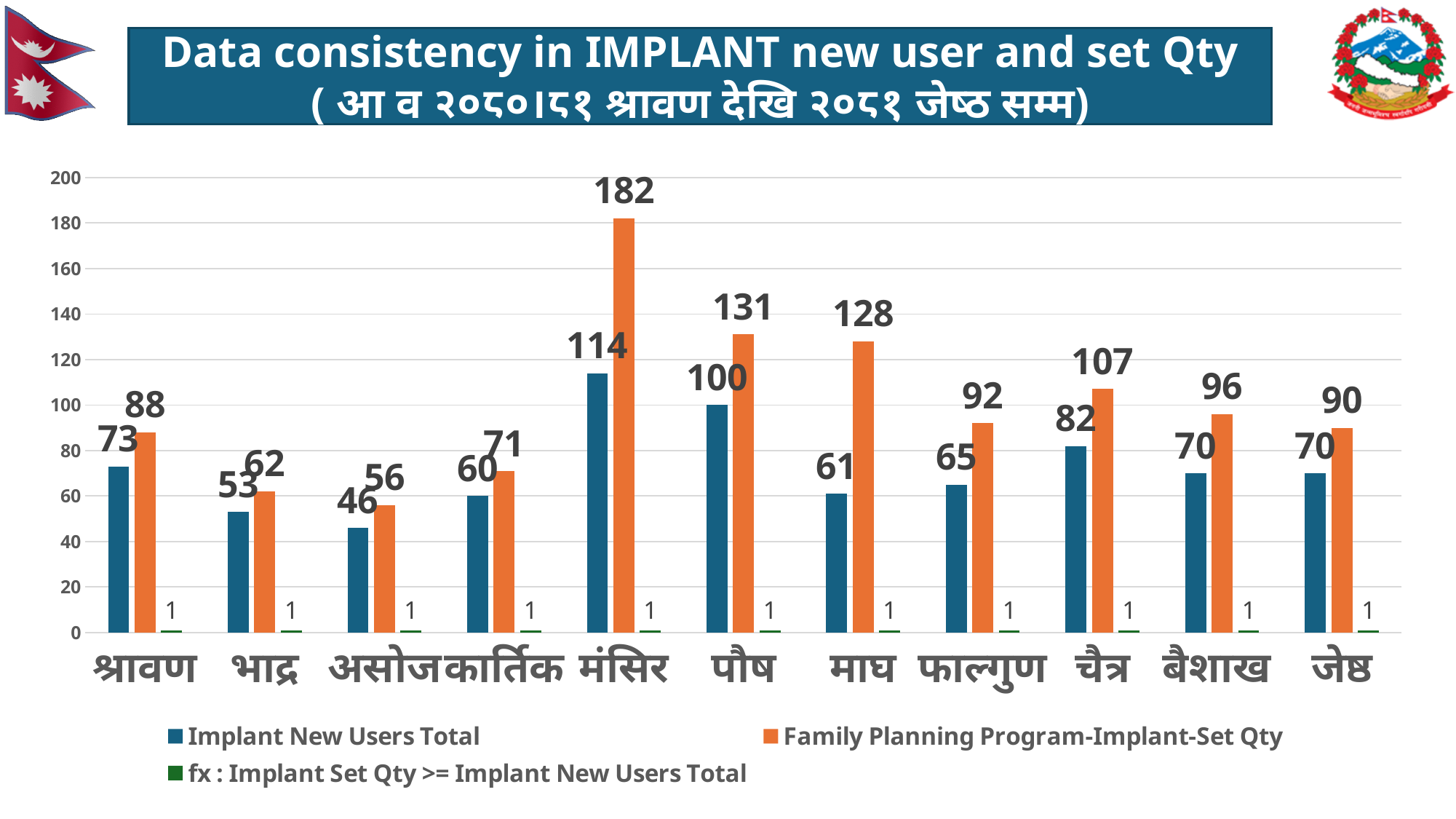
What is the Family Planning Program-Implant-Set Qty value for मंसिर? 182 What is the Implant New Users Total value for पौष? 100 How many series does the legend list? 3 What is the difference between the Implant Set Qty and the Implant New Users Total for माघ? 67 What colour are the Family Planning Program-Implant-Set Qty bars? Orange What value does the fx : Implant Set Qty >= Implant New Users Total series show for every month? 1 Which month has the lowest Implant New Users Total? असोज Which month has the highest Family Planning Program-Implant-Set Qty? मंसिर How many months are shown on the x axis? 11 Which is larger for चैत्र: the Implant New Users Total or the Family Planning Program-Implant-Set Qty? Family Planning Program-Implant-Set Qty What kind of chart is shown on the slide? Bar chart What is the Implant New Users Total value for असोज? 46